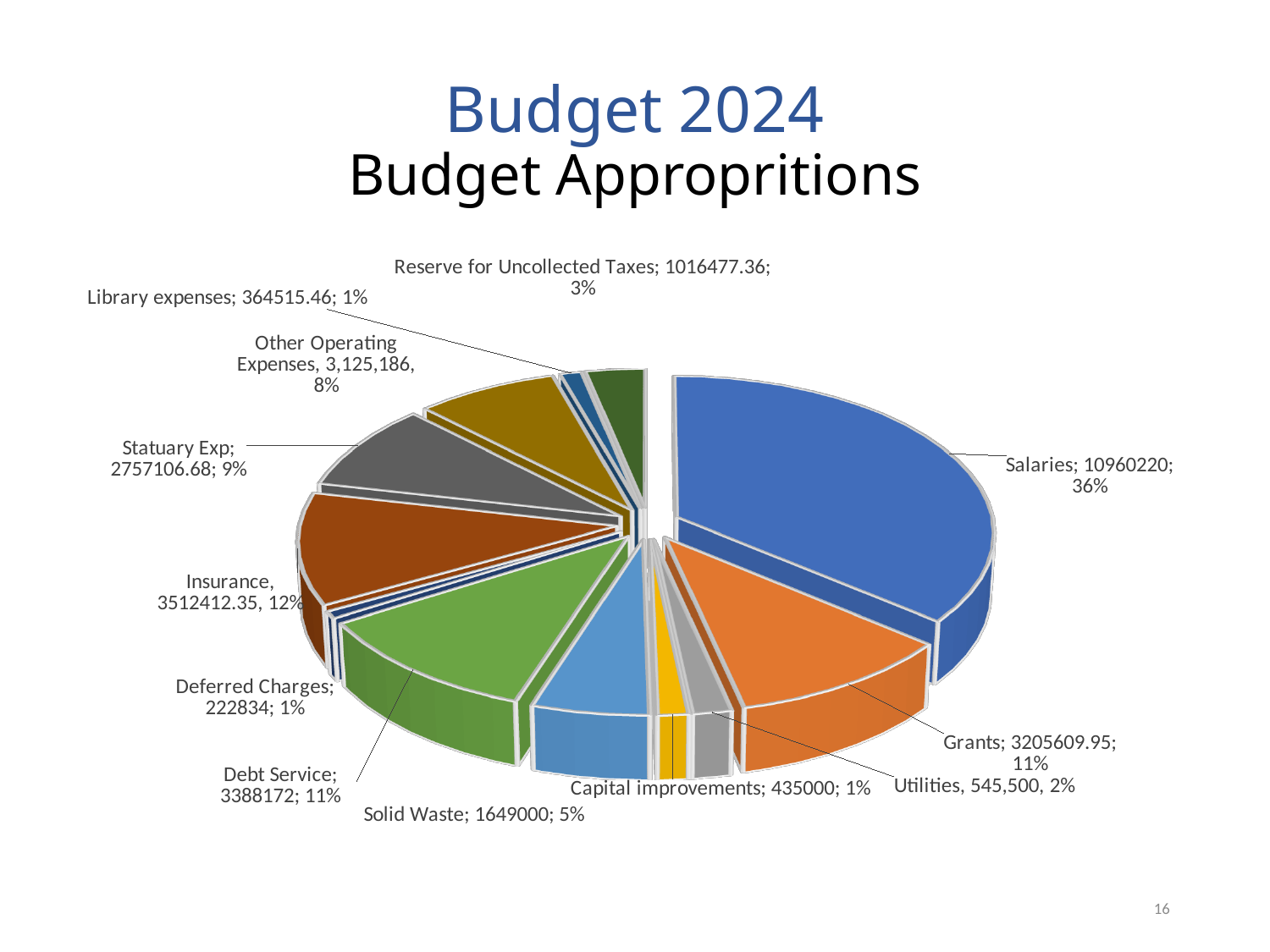
Which category has the largest slice of the pie? Salaries What is the value for Solid Waste? 1649000 What is the value for Reserve for Uncollected Taxes? 1016477.36 What is the difference between the values for Debt Service and Solid Waste? 1739172 What share of the pie does Insurance represent? 12% What type of chart is shown on the slide? Pie chart What is the value for Grants? 3205609.95 Which is larger, Debt Service or Solid Waste? Debt Service How many categories are shown in the pie chart? 12 What share of the pie does Statuary Exp represent? 9% What is the value for Salaries? 10960220 Which category has the smallest value? Deferred Charges